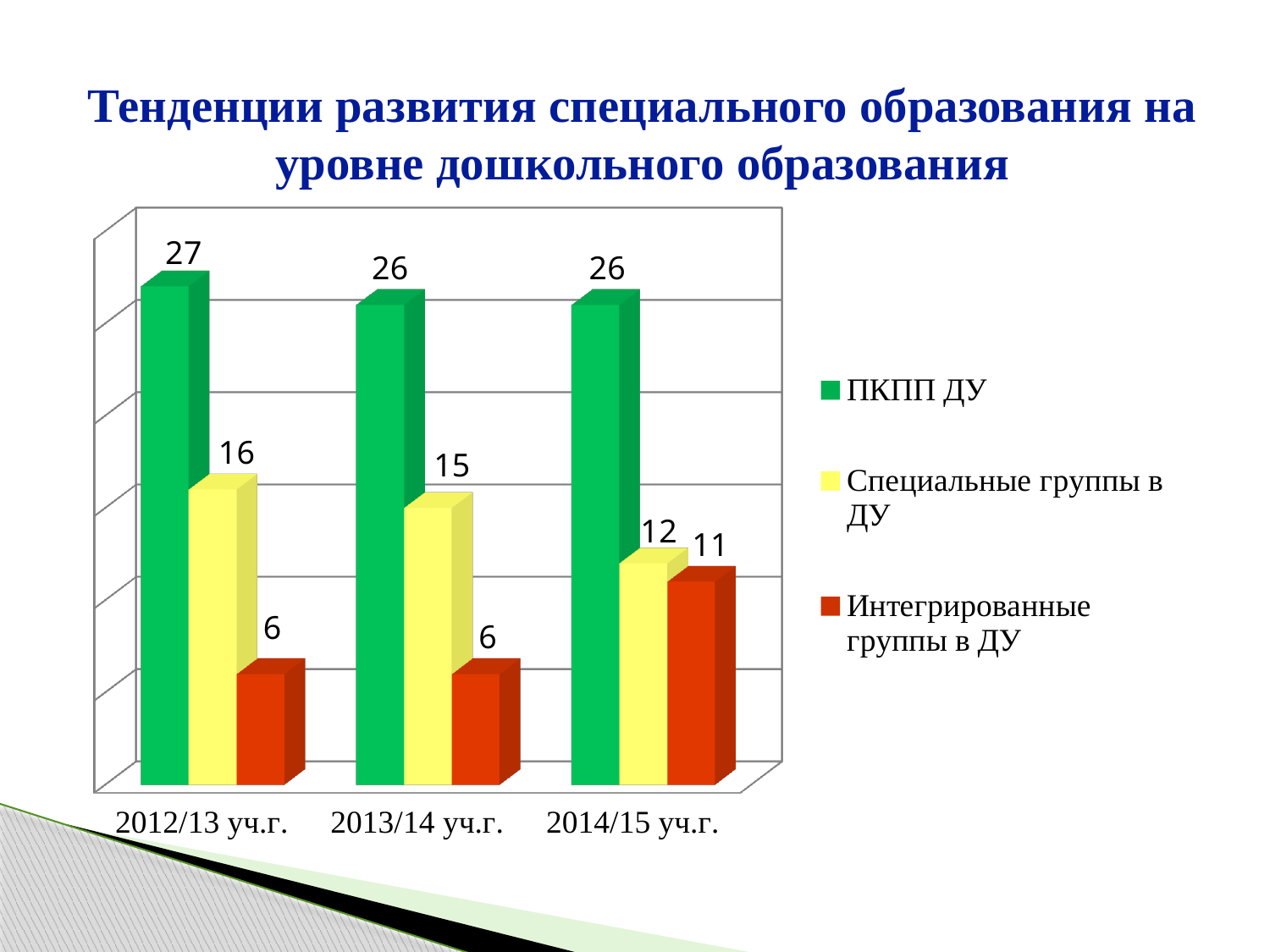
How many series does the legend list? 3 What is the difference between ПКПП ДУ and Специальные группы в ДУ in 2012/13 уч.г.? 11 What is the value for Специальные группы в ДУ in 2013/14 уч.г.? 15 Does the value for Интегрированные группы в ДУ rise or fall from 2013/14 уч.г. to 2014/15 уч.г.? rise In which year is the value for Специальные группы в ДУ the lowest? 2014/15 уч.г. How many years are shown on the x axis? 3 In which year is the value for ПКПП ДУ the highest? 2012/13 уч.г. What kind of chart is shown on the slide? bar chart What is the difference between Интегрированные группы в ДУ in 2014/15 уч.г. and in 2013/14 уч.г.? 5 What is the value for Интегрированные группы в ДУ in 2014/15 уч.г.? 11 Which is larger in 2014/15 уч.г.: Специальные группы в ДУ or Интегрированные группы в ДУ? Специальные группы в ДУ What is the value for ПКПП ДУ in 2012/13 уч.г.? 27